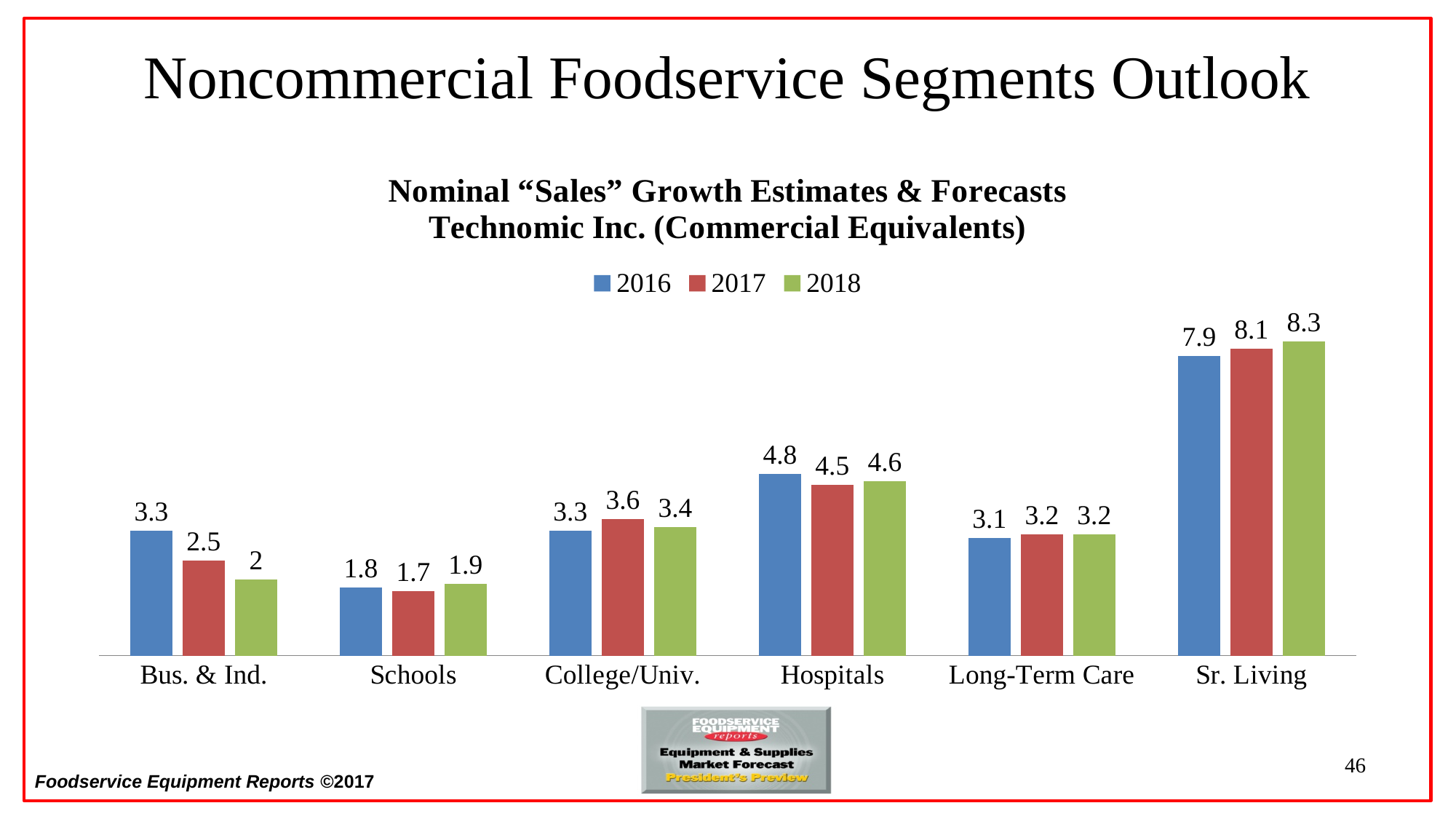
How many series does the legend list? 3 Which series is shown in green in the legend? 2018 How many categories are shown on the x axis? 6 What is the 2017 value for Bus. & Ind.? 2.5 Which is larger for College/Univ., the 2017 value or the 2018 value? 2017 Which category has the lowest 2017 value? Schools What is the 2018 value for Schools? 1.9 What kind of chart is shown on the slide? Bar chart Do the values for Sr. Living rise or fall from 2016 to 2018? Rise What is the 2016 value for Hospitals? 4.8 What is the difference between the 2018 and 2016 values for Sr. Living? 0.4 Which category has the highest 2018 value? Sr. Living